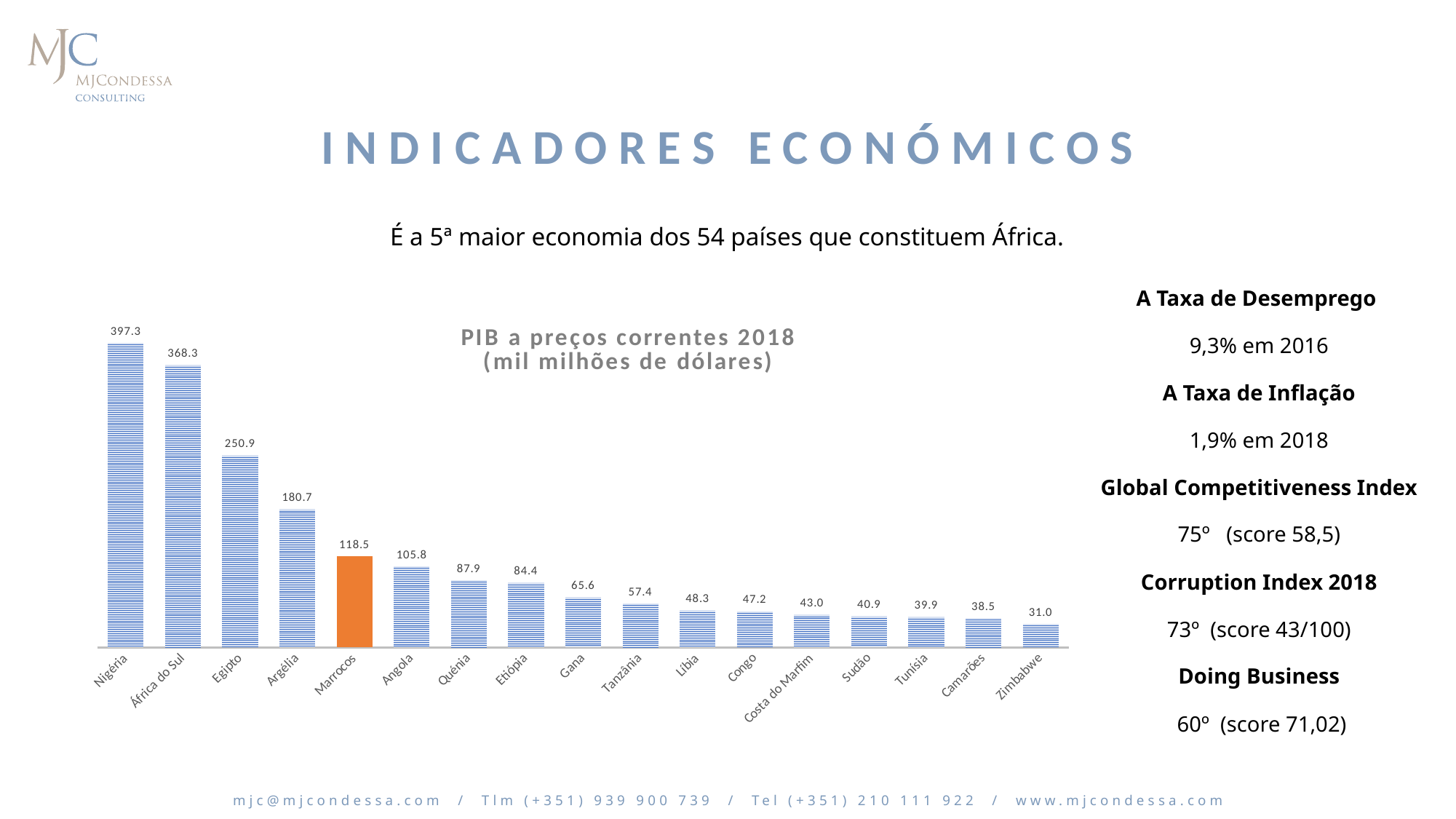
What kind of chart is shown on the slide? Bar chart What is the difference between the values for Marrocos and Angola? 12.7 What is the value for Marrocos in the chart? 118.5 Which country has the lowest value in the chart? Zimbabwe Do the values rise or fall from left to right along the x axis? Fall Which is larger, the value for Argélia or the value for Angola? Argélia Which country's bar is highlighted in orange in the chart? Marrocos How many countries are shown in the chart? 17 What is the value for Egipto in the chart? 250.9 What is the value for Zimbabwe in the chart? 31.0 What is the difference between the values for Nigéria and África do Sul? 29.0 Which country has the highest value in the chart? Nigéria